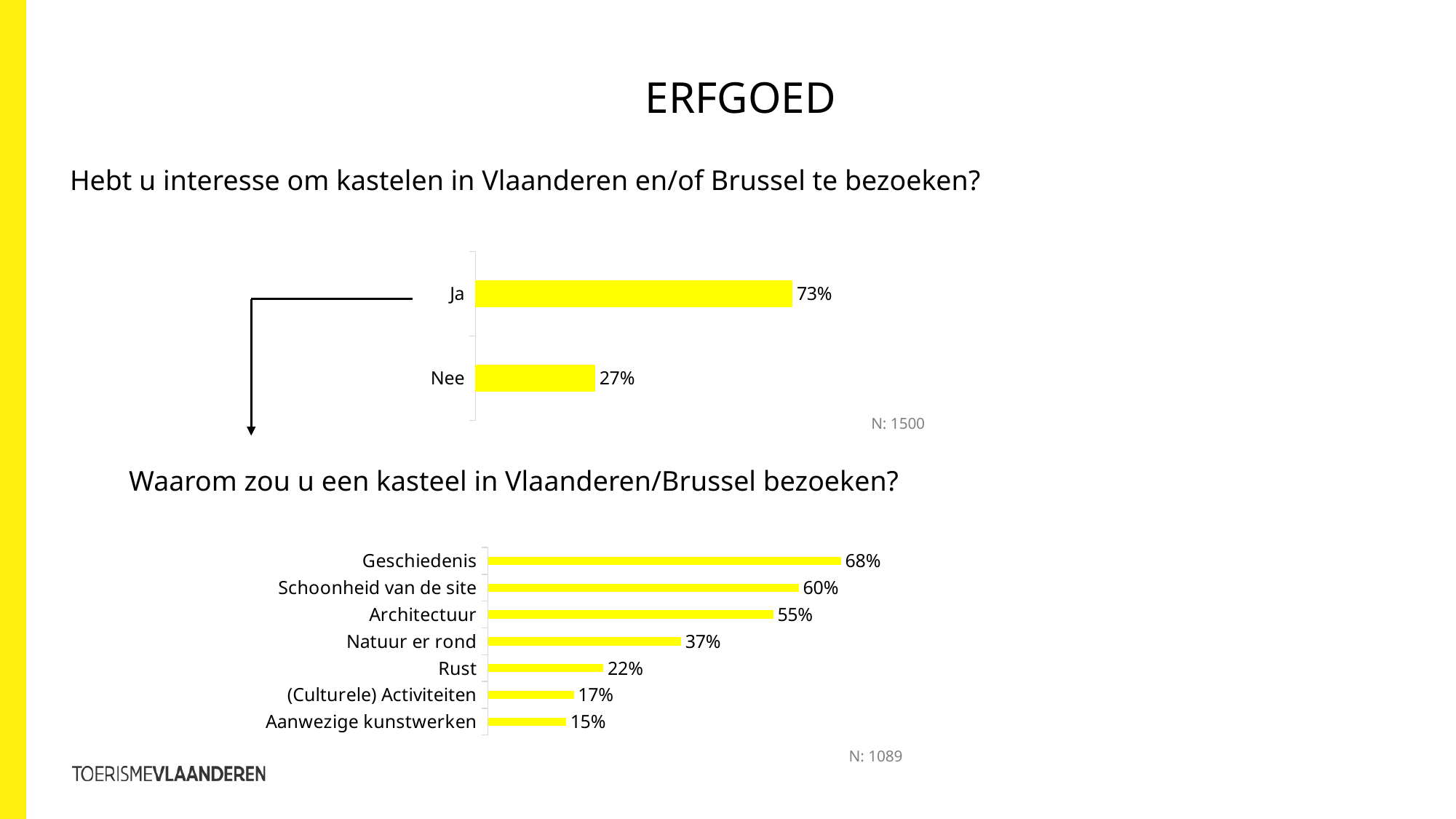
In the bottom chart (Waarom zou u een kasteel in Vlaanderen/Brussel bezoeken?), what is the difference between Schoonheid van de site and Architectuur? 5% In the top chart (Hebt u interesse om kastelen in Vlaanderen en/of Brussel te bezoeken?), what is the difference between Ja and Nee? 46% In the bottom chart (Waarom zou u een kasteel in Vlaanderen/Brussel bezoeken?), which category has the highest value? Geschiedenis In the bottom chart (Waarom zou u een kasteel in Vlaanderen/Brussel bezoeken?), how many categories are shown? 7 In the top chart (Hebt u interesse om kastelen in Vlaanderen en/of Brussel te bezoeken?), what is the value for Ja? 73% In the bottom chart (Waarom zou u een kasteel in Vlaanderen/Brussel bezoeken?), what is the value for Natuur er rond? 37% In the top chart (Hebt u interesse om kastelen in Vlaanderen en/of Brussel te bezoeken?), what is the value for Nee? 27% In the top chart (Hebt u interesse om kastelen in Vlaanderen en/of Brussel te bezoeken?), how many categories are shown? 2 In the bottom chart (Waarom zou u een kasteel in Vlaanderen/Brussel bezoeken?), which is larger: Rust or (Culturele) Activiteiten? Rust What kind of chart is the bottom chart (Waarom zou u een kasteel in Vlaanderen/Brussel bezoeken?)? Bar chart In the bottom chart (Waarom zou u een kasteel in Vlaanderen/Brussel bezoeken?), what is the value for Geschiedenis? 68% In the bottom chart (Waarom zou u een kasteel in Vlaanderen/Brussel bezoeken?), which category has the lowest value? Aanwezige kunstwerken